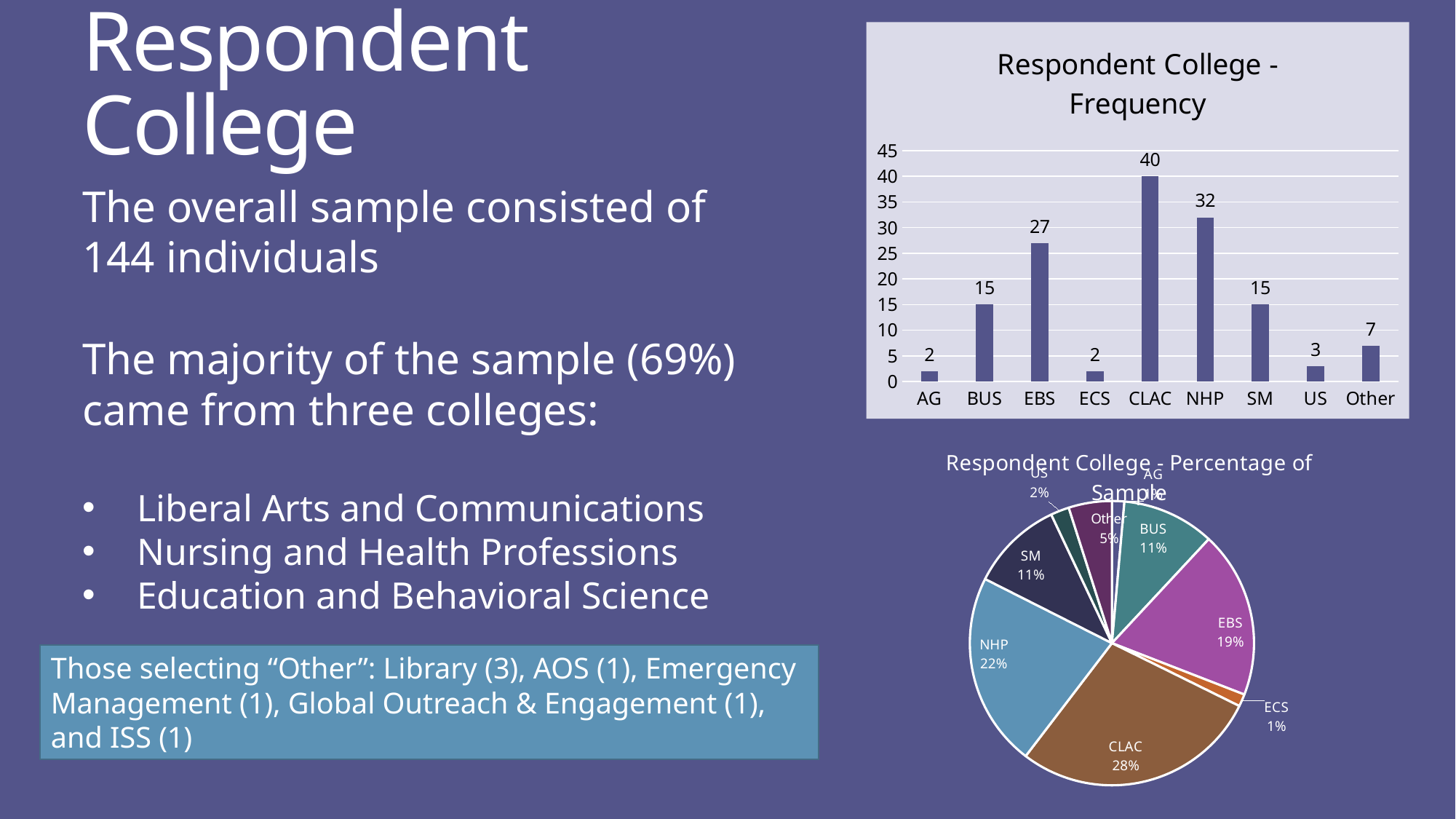
In the Respondent College - Frequency bar chart, what is the value for Other? 7 In the Respondent College - Frequency bar chart, how many categories are shown on the x axis? 9 In the Respondent College - Frequency bar chart, which category has the highest value? CLAC In the Respondent College - Frequency bar chart, what is the difference between the values for CLAC and NHP? 8 In the Respondent College - Percentage of Sample pie chart, what share does NHP have? 22% In the Respondent College - Frequency bar chart, what is the value for EBS? 27 What kind of chart is the Respondent College - Frequency chart? bar chart What kind of chart is the Respondent College - Percentage of Sample chart? pie chart In the Respondent College - Frequency bar chart, what is the value for CLAC? 40 In the Respondent College - Frequency bar chart, which is larger, the value for BUS or the value for US? BUS In the Respondent College - Percentage of Sample pie chart, which is larger, the share for EBS or the share for SM? EBS In the Respondent College - Percentage of Sample pie chart, what share does CLAC have? 28%